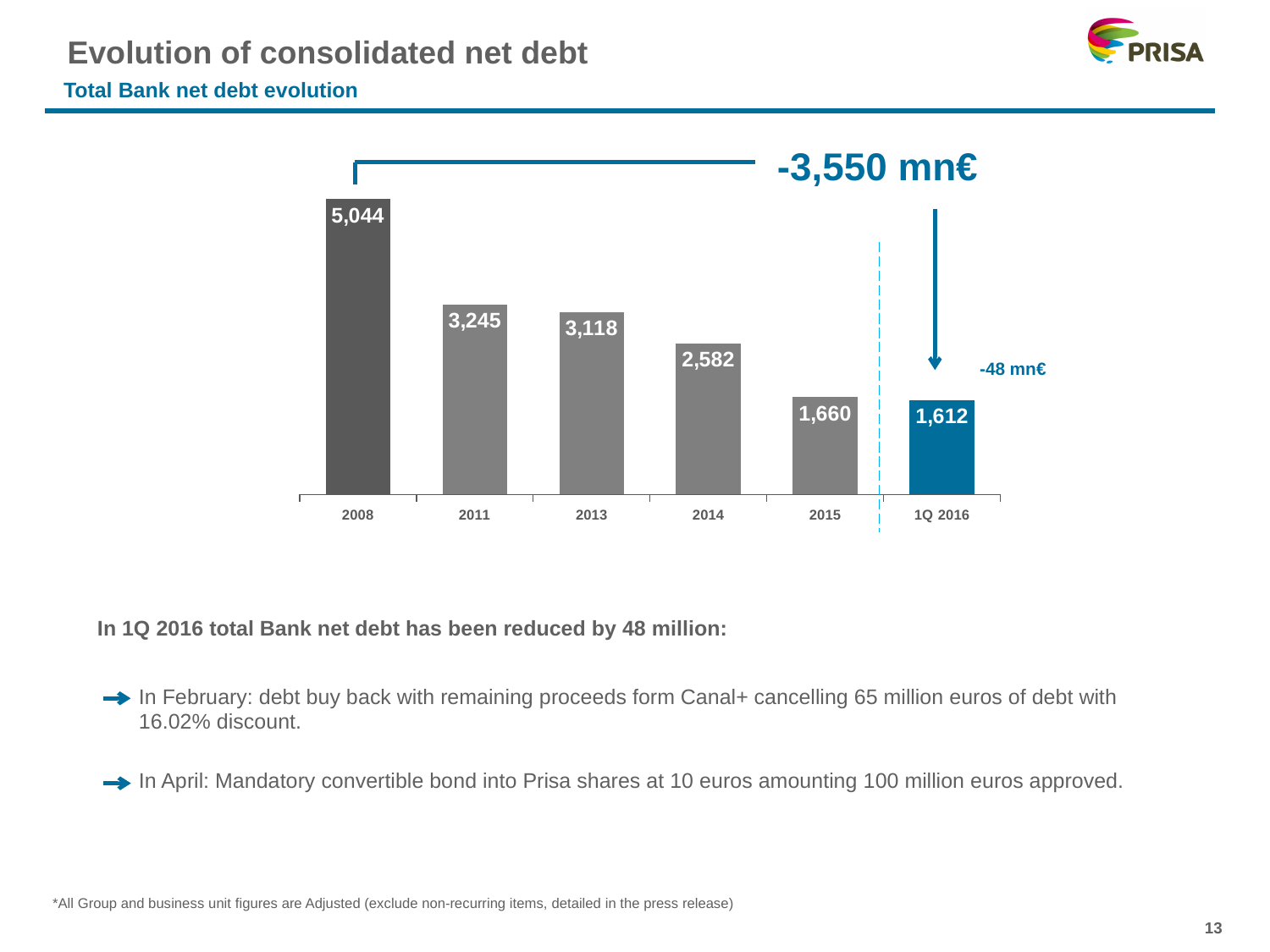
What reduction in net debt is annotated above the chart with the large arrow? -3,550 mn€ Which year has the highest total Bank net debt on the chart? 2008 Which is larger, the net debt in 2011 or in 2013? 2011 What kind of chart is used to show the total Bank net debt evolution? Bar chart Which period has the lowest total Bank net debt on the chart? 1Q 2016 What is the total Bank net debt value shown for 2014? 2,582 What is the difference between the net debt in 2008 and in 1Q 2016? 3,432 What is the total Bank net debt value shown for 2008? 5,044 What is the total Bank net debt value shown for 1Q 2016? 1,612 What is the difference between the net debt in 2015 and in 1Q 2016? 48 Do the net debt values rise or fall from 2008 to 1Q 2016? Fall How many periods are shown on the x axis of the chart? 6